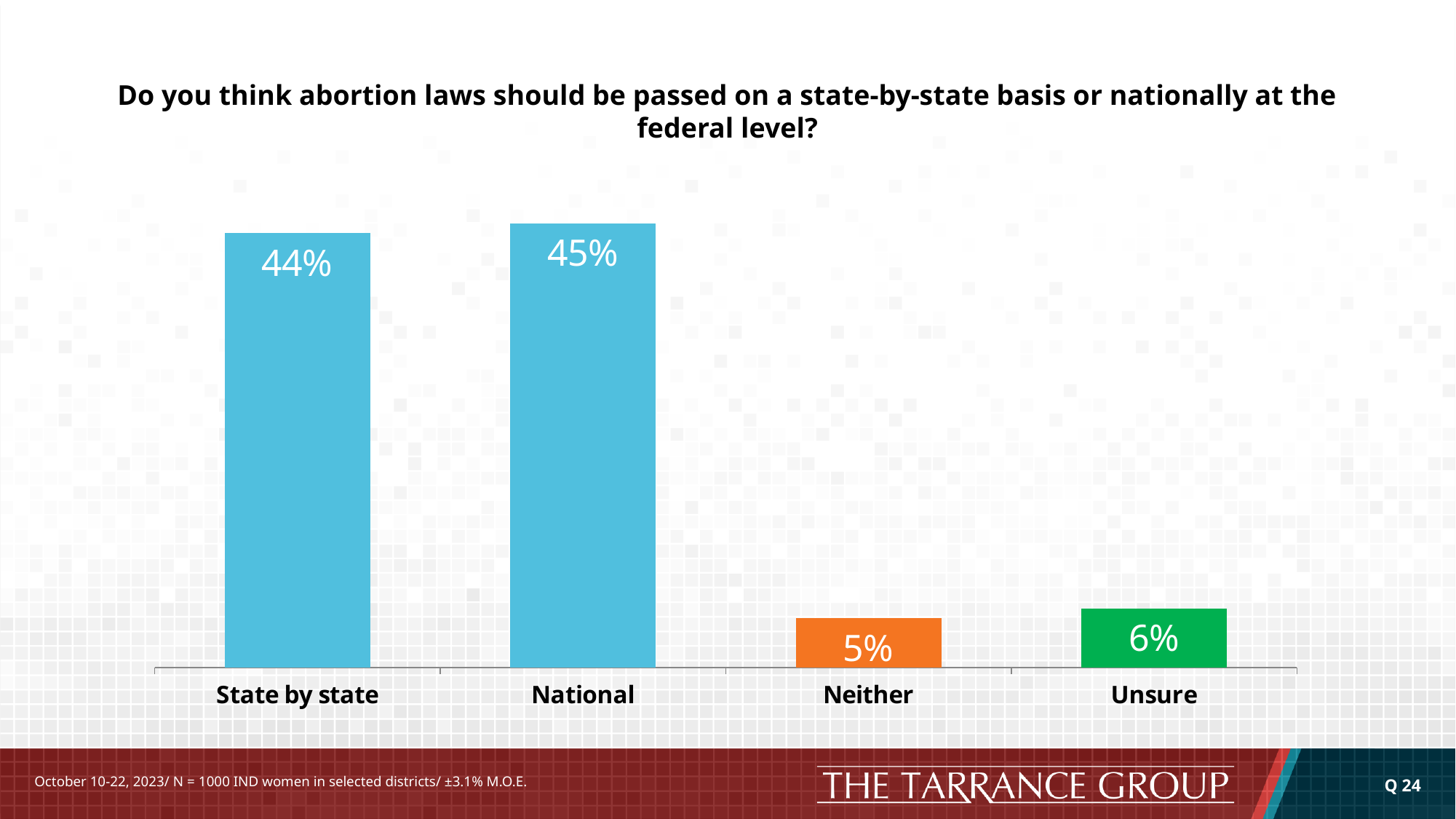
What percentage of respondents said abortion laws should be passed on a state-by-state basis? 44% What percentage of respondents answered Neither? 5% Which category has the lowest value? Neither What is the combined total of the State by state and National values? 89% What is the difference between the Unsure and Neither values? 1% What colour is the Neither bar? Orange How many categories are shown on the x axis? 4 What is the difference between the National and State by state values? 1% What kind of chart is shown on the slide? Bar chart What is the value for Unsure? 6% What colour is the Unsure bar? Green What is the value shown for the National bar? 45%